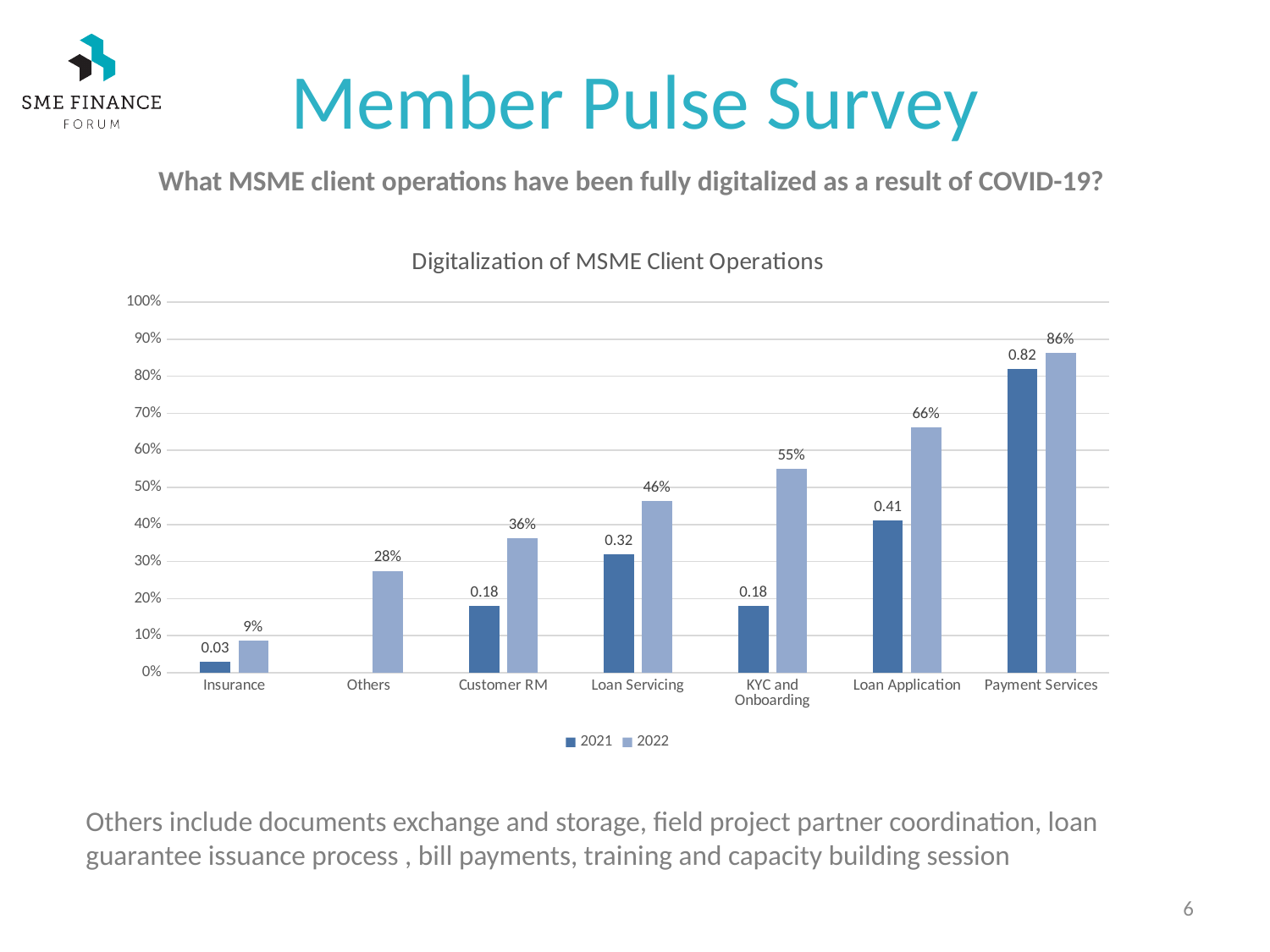
What is the 2022 value for KYC and Onboarding? 55% How many series does the chart legend list? 2 How many categories are shown on the x axis of the chart? 7 Which category has the lowest 2022 value? Insurance What kind of chart is shown on the slide? Bar chart What is the 2021 value for Loan Application? 0.41 What is the difference between the 2022 values for Payment Services and Loan Application? 20% What is the 2022 value for Payment Services in the Digitalization of MSME Client Operations chart? 86% Which is larger: the 2022 value for Customer RM or the 2022 value for Loan Servicing? Loan Servicing What is the title of the chart? Digitalization of MSME Client Operations What is the 2021 value for Insurance? 0.03 Which category has the highest 2022 value? Payment Services